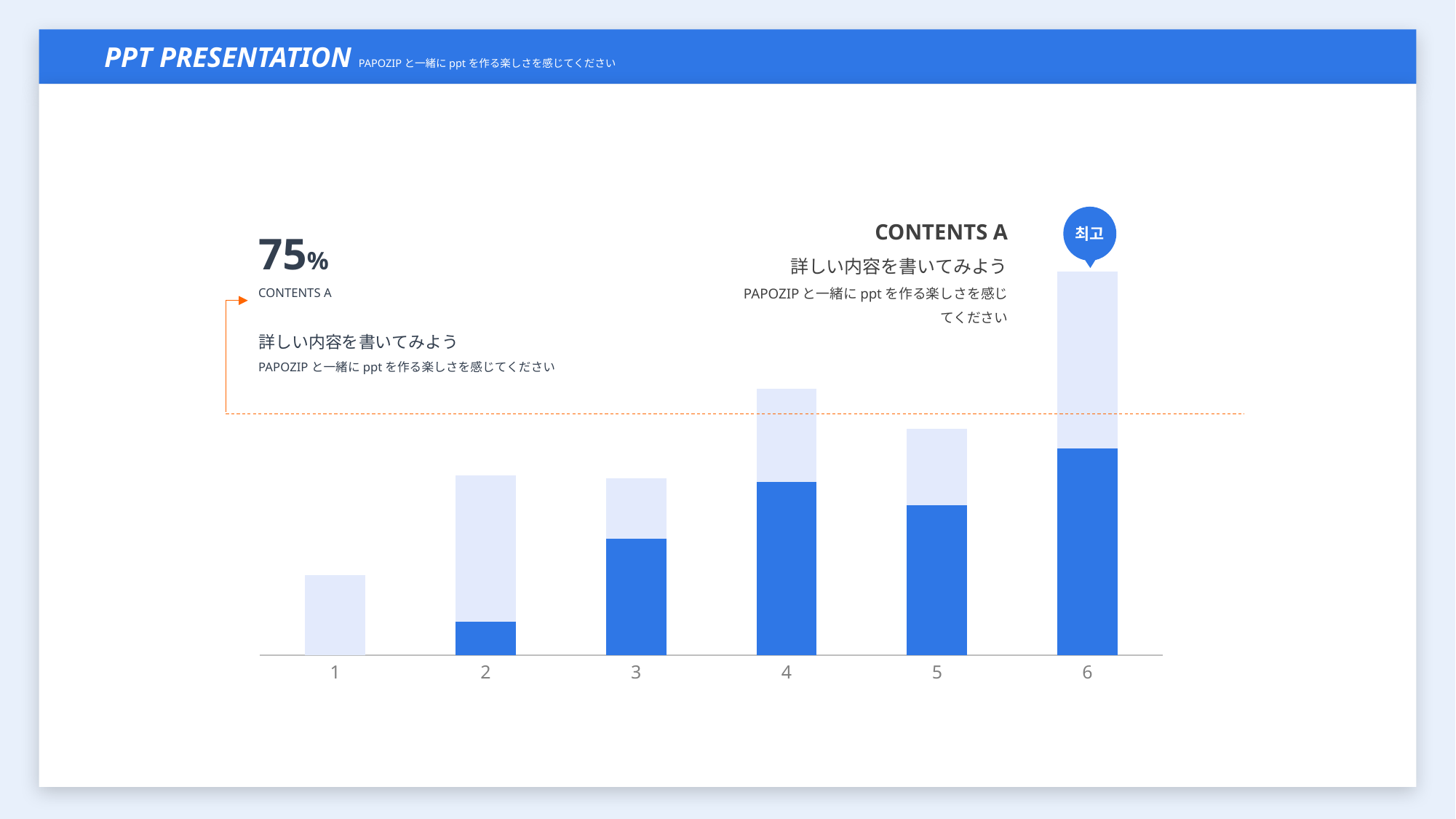
Which category has the tallest bar in the chart? 6 Which category has the largest dark blue segment in its bar? 6 What kind of chart is shown on the slide? bar chart How many categories are shown on the x axis of the bar chart? 6 Is the bar for category 6 taller than the bar for category 4? yes Which category's bar has no dark blue segment at all? 1 What label is shown in the callout bubble above the bar for category 6? 최고 Which bar is taller, category 1 or category 2? 2 Which category has the shortest bar in the chart? 1 Which bar is taller, category 1 or category 6? 6